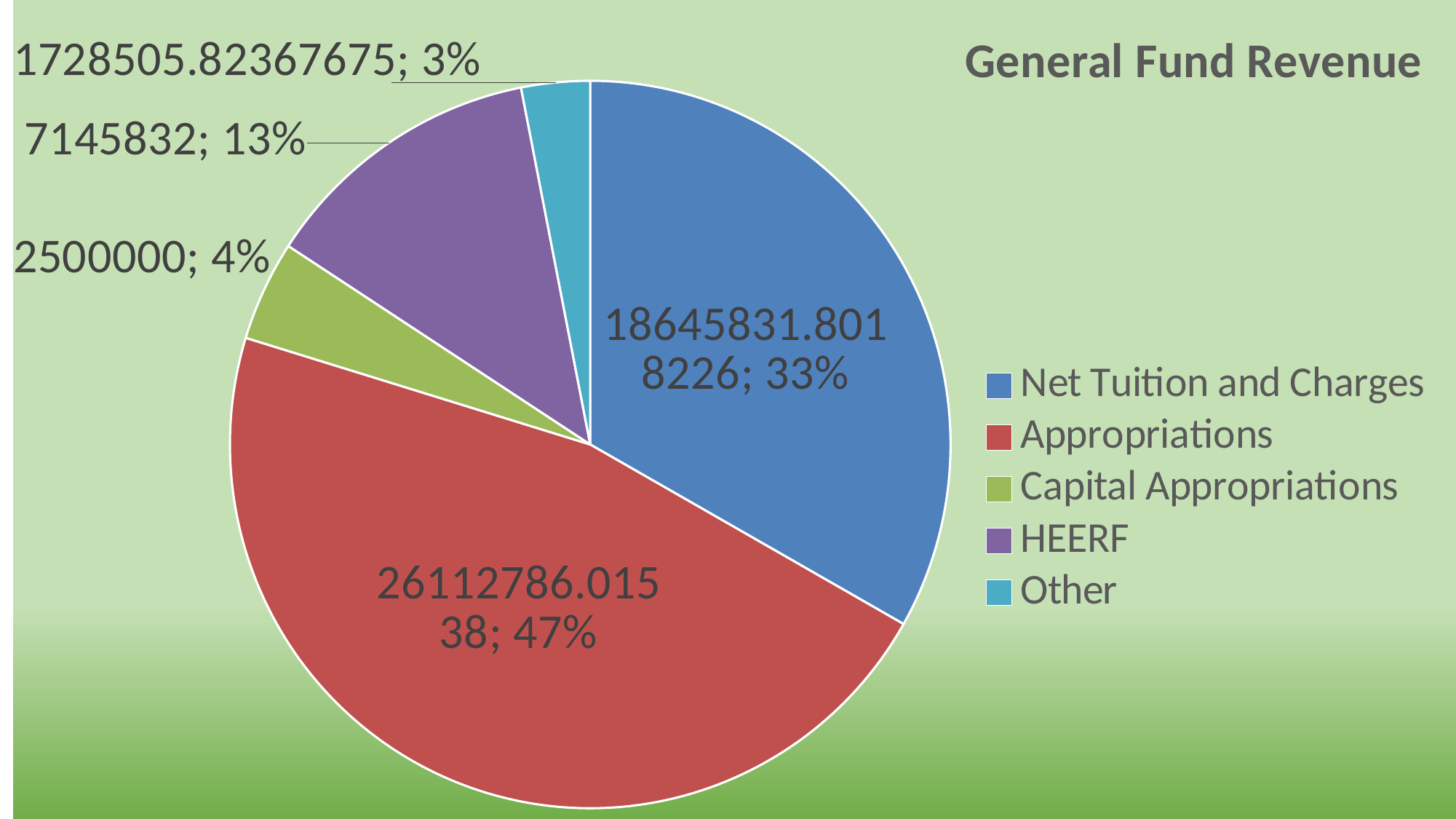
What percentage share of General Fund Revenue is HEERF? 13% Which category has the smallest share of General Fund Revenue? Other What kind of chart is shown on the slide? pie chart What is the title of the chart? General Fund Revenue What percentage share of General Fund Revenue is Appropriations? 47% Which category has the largest share of General Fund Revenue? Appropriations What is the value shown for Capital Appropriations? 2500000 What percentage share of General Fund Revenue is Net Tuition and Charges? 33% How many slices does the pie chart have? 5 Which is larger, the share for HEERF or the share for Capital Appropriations? HEERF What is the value shown for HEERF? 7145832